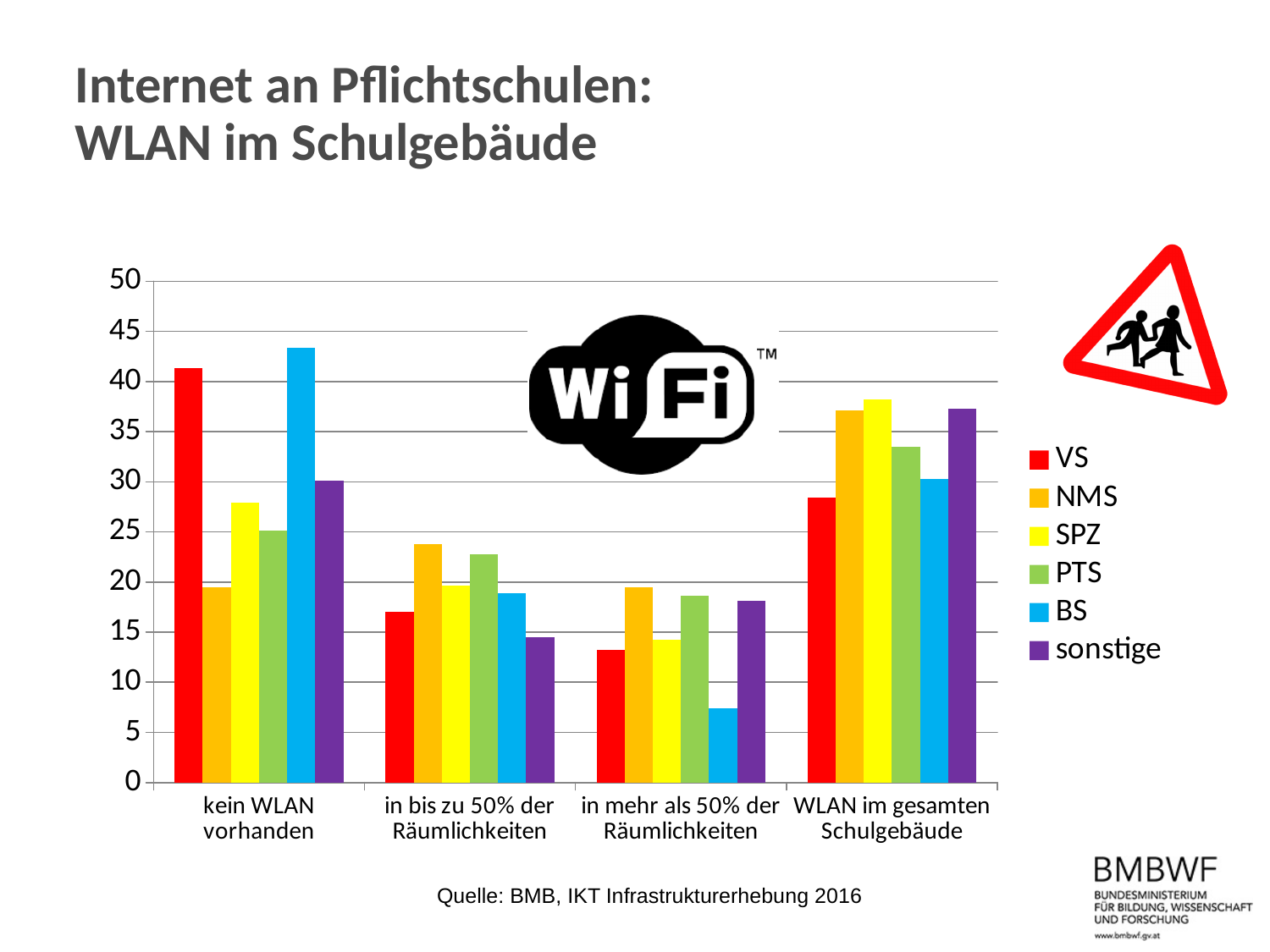
Is the value for NMS in the category 'WLAN im gesamten Schulgebäude' greater or less than 35? greater In the category 'kein WLAN vorhanden', which school type has the highest value? BS Is the value for VS in the category 'kein WLAN vorhanden' greater or less than 40? greater What kind of chart is shown on the slide? bar chart Which colour represents the BS series in the legend? blue In the category 'in bis zu 50% der Räumlichkeiten', which school type has the lowest value? sonstige How many series does the chart's legend list? 6 In the category 'kein WLAN vorhanden', which is larger: the value for VS or the value for NMS? VS In the category 'in mehr als 50% der Räumlichkeiten', which school type has the lowest value? BS Is the value for BS in the category 'in mehr als 50% der Räumlichkeiten' greater or less than 10? less How many categories are shown along the x axis of the chart? 4